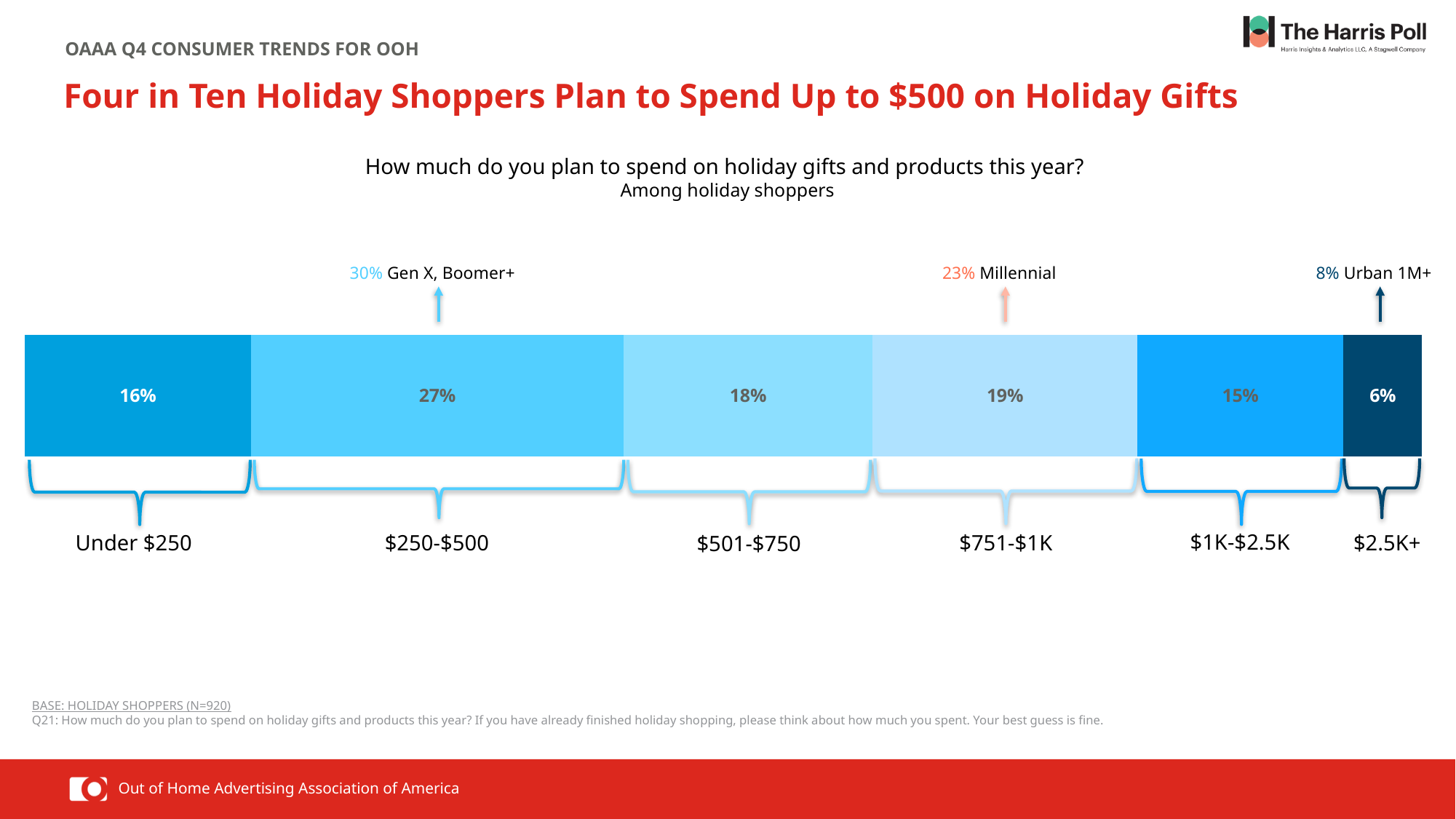
How many spending range segments are shown in the bar? 6 Which spending range has the highest share of holiday shoppers? $250-$500 Which spending range has the lowest share of holiday shoppers? $2.5K+ Which segment is larger: $751-$1K or $1K-$2.5K? $751-$1K What percentage of holiday shoppers plan to spend $250-$500 on holiday gifts? 27% What is the difference in percentage points between the $250-$500 segment and the $501-$750 segment? 9 What percentage of holiday shoppers plan to spend under $250? 16% What percentage of holiday shoppers plan to spend $751-$1K? 19% What percentage of Gen X, Boomer+ shoppers plan to spend $250-$500, according to the callout? 30% What percentage of Millennial shoppers plan to spend $751-$1K, according to the callout? 23% What percentage of holiday shoppers plan to spend $2.5K+? 6% What is the combined percentage of holiday shoppers planning to spend under $250 or $250-$500? 43%